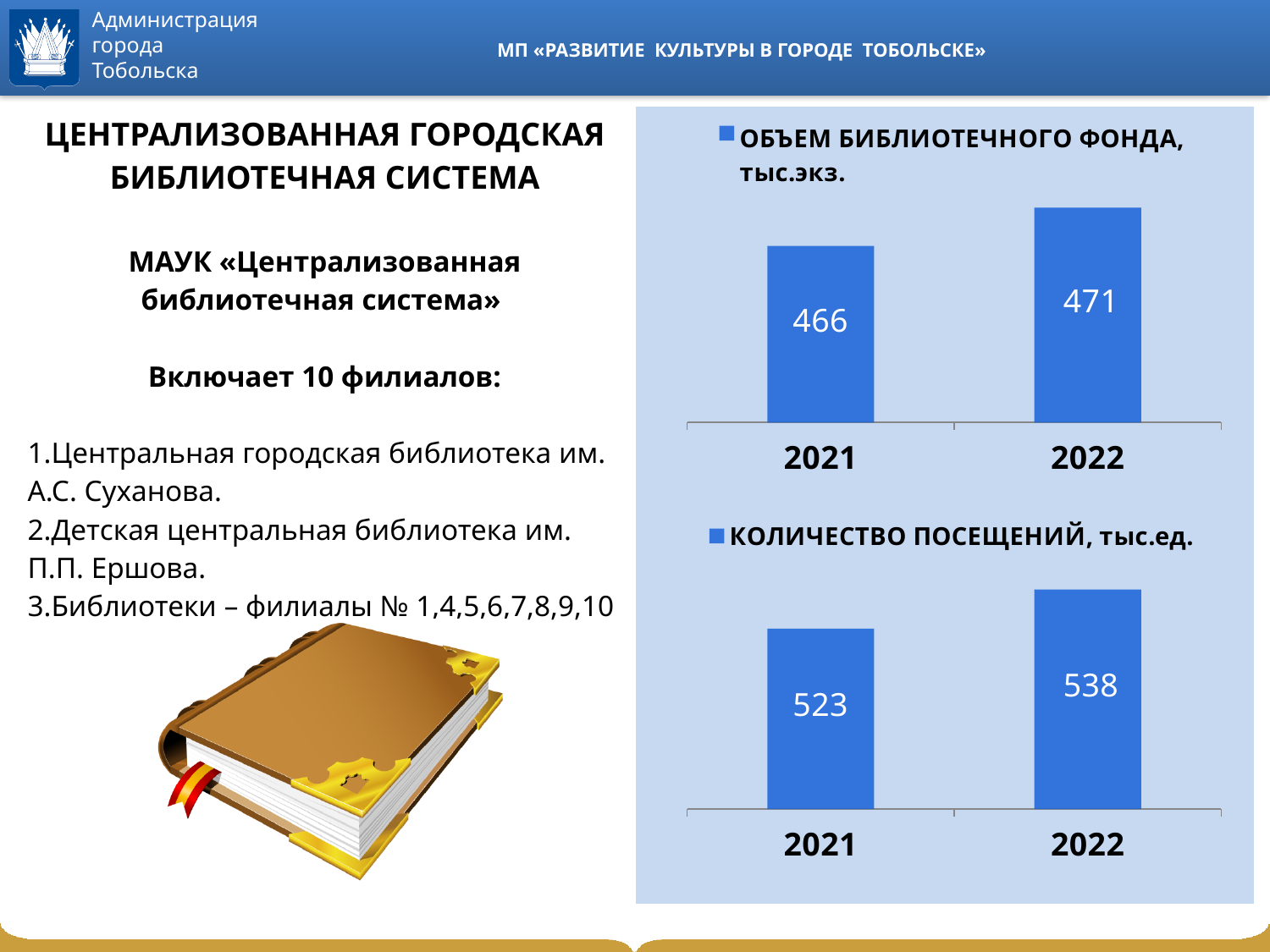
In the chart titled «КОЛИЧЕСТВО ПОСЕЩЕНИЙ, тыс.ед.», what is the value for 2021? 523 In the chart titled «КОЛИЧЕСТВО ПОСЕЩЕНИЙ, тыс.ед.», what is the value for 2022? 538 In the chart titled «КОЛИЧЕСТВО ПОСЕЩЕНИЙ, тыс.ед.», do the values rise or fall from 2021 to 2022? rise How many categories (years) are shown in the chart titled «ОБЪЕМ БИБЛИОТЕЧНОГО ФОНДА, тыс.экз.»? 2 In the chart titled «ОБЪЕМ БИБЛИОТЕЧНОГО ФОНДА, тыс.экз.», what is the value for 2022? 471 What kind of chart is the chart titled «КОЛИЧЕСТВО ПОСЕЩЕНИЙ, тыс.ед.»? bar chart In the chart titled «ОБЪЕМ БИБЛИОТЕЧНОГО ФОНДА, тыс.экз.», by how much does the 2022 value exceed the 2021 value? 5 In the chart titled «КОЛИЧЕСТВО ПОСЕЩЕНИЙ, тыс.ед.», which year has the lower value? 2021 In the chart titled «ОБЪЕМ БИБЛИОТЕЧНОГО ФОНДА, тыс.экз.», which year has the higher value? 2022 In the chart titled «ОБЪЕМ БИБЛИОТЕЧНОГО ФОНДА, тыс.экз.», what is the value for 2021? 466 What is the title of the upper chart on the right side of the slide? ОБЪЕМ БИБЛИОТЕЧНОГО ФОНДА, тыс.экз. In the chart titled «КОЛИЧЕСТВО ПОСЕЩЕНИЙ, тыс.ед.», what is the difference between the 2022 and 2021 values? 15